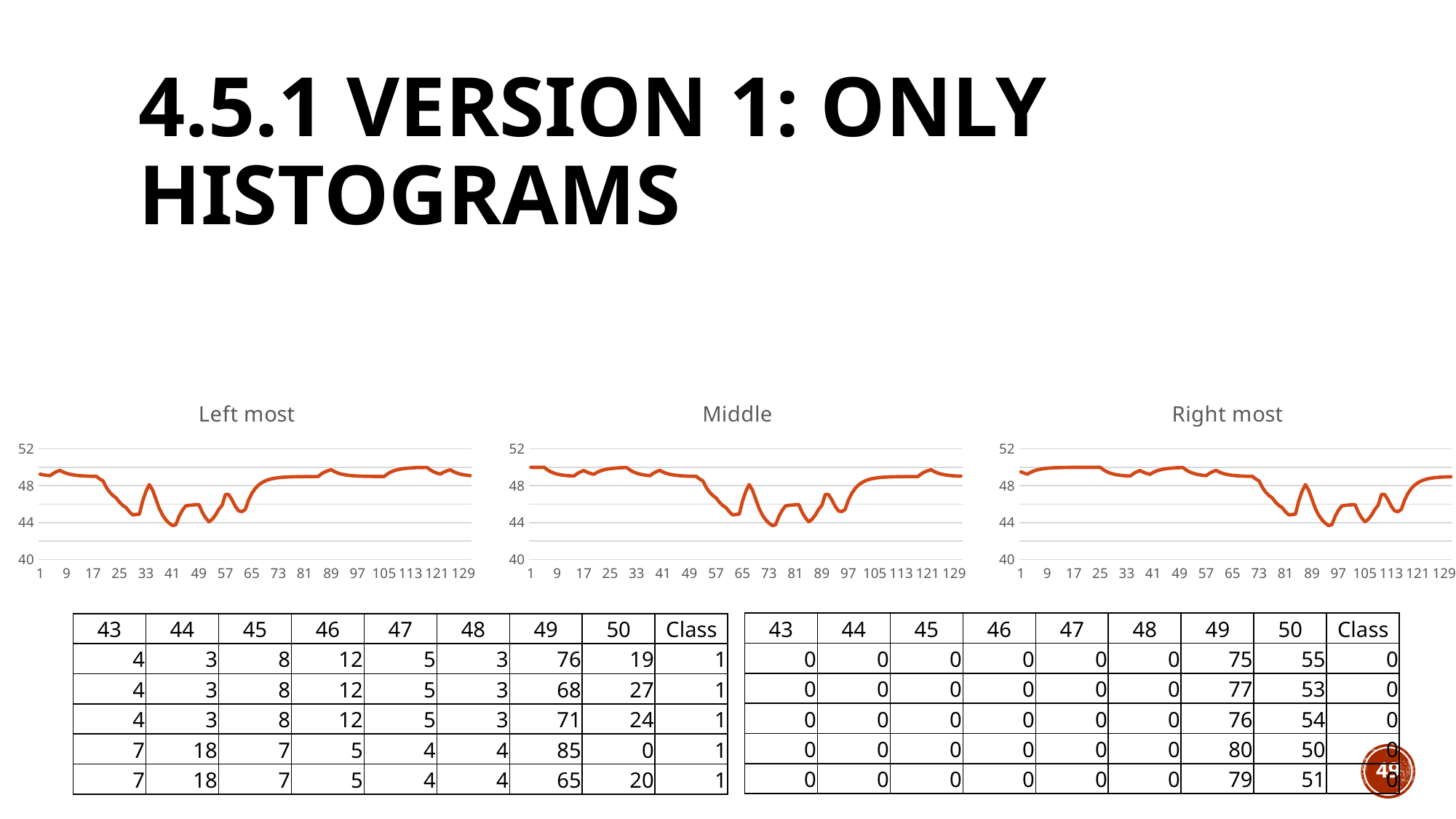
In the "Left most" chart, is the value at x = 1 greater or less than 48? greater In the "Middle" chart, is the value at x = 73 greater or less than 48? less In the "Left most" chart, is the value at x = 41 greater or less than 48? less How many charts are shown on the slide? 3 What kind of chart is the "Left most" chart? line chart What is the title of the chart in the centre of the slide? Middle What is the highest tick value shown on the y axis of the "Middle" chart? 52 What is the title of the chart on the right side of the slide? Right most In the "Right most" chart, is the value at x = 49 larger or smaller than the value at x = 97? larger